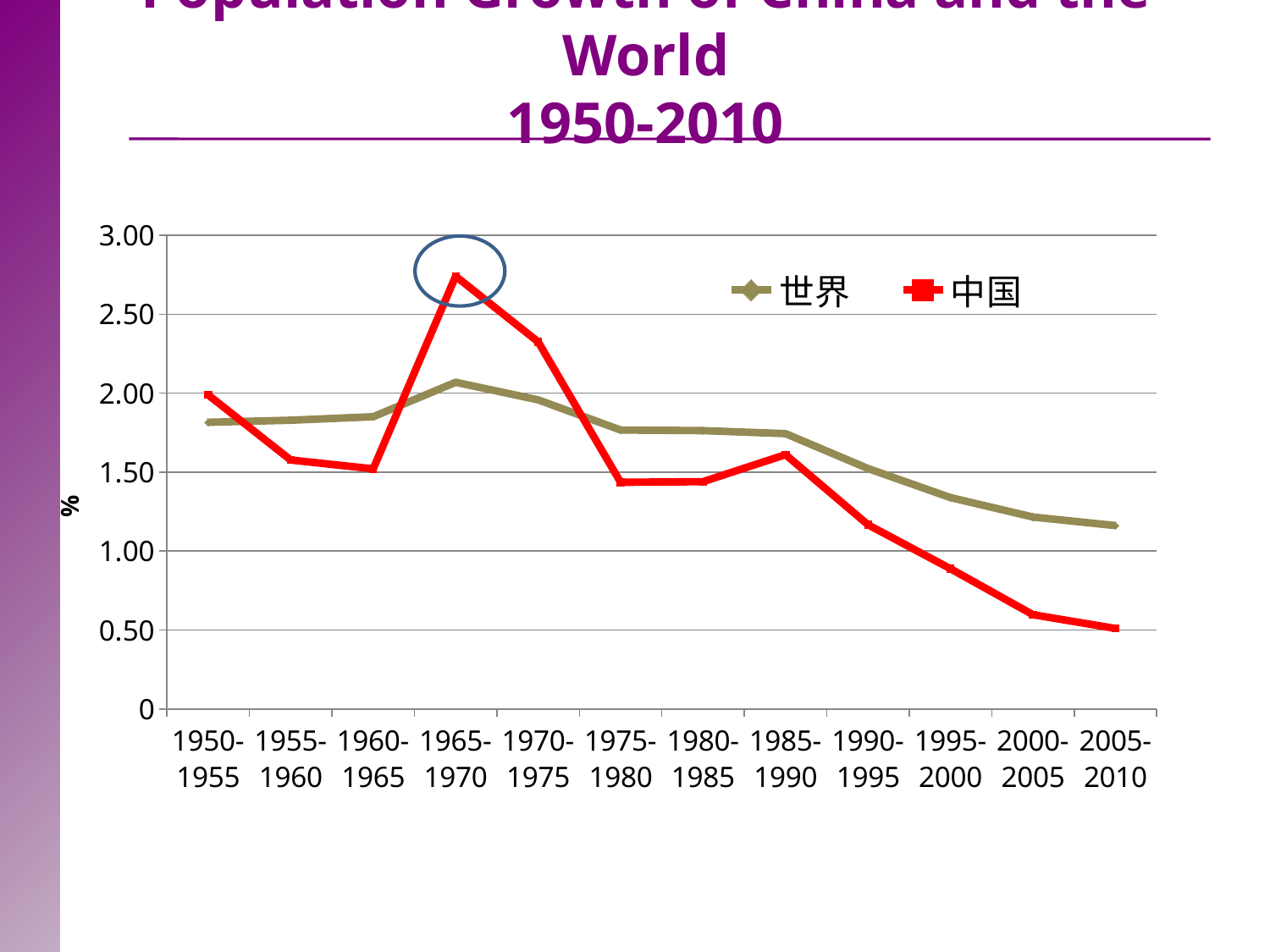
In 1965-1970, which series has the larger value, 世界 (World) or 中国 (China)? 中国 In 2005-2010, which series has the larger value, 世界 (World) or 中国 (China)? 世界 How many time periods are shown along the x axis? 12 In which period does the 世界 (World) series reach its lowest value? 2005-2010 Is the value for 世界 (World) in 2005-2010 greater or less than 1.50? less Does the 世界 (World) series rise or fall from 1985-1990 to 2005-2010? fall How many series does the legend list? 2 What kind of chart is shown on the slide? line chart Is the value for 中国 (China) in 2005-2010 greater or less than 1.00? less In which period does the 中国 (China) series reach its highest value? 1965-1970 In which period does the 中国 (China) series reach its lowest value? 2005-2010 Is the value for 中国 (China) in 1965-1970 greater or less than 2.50? greater